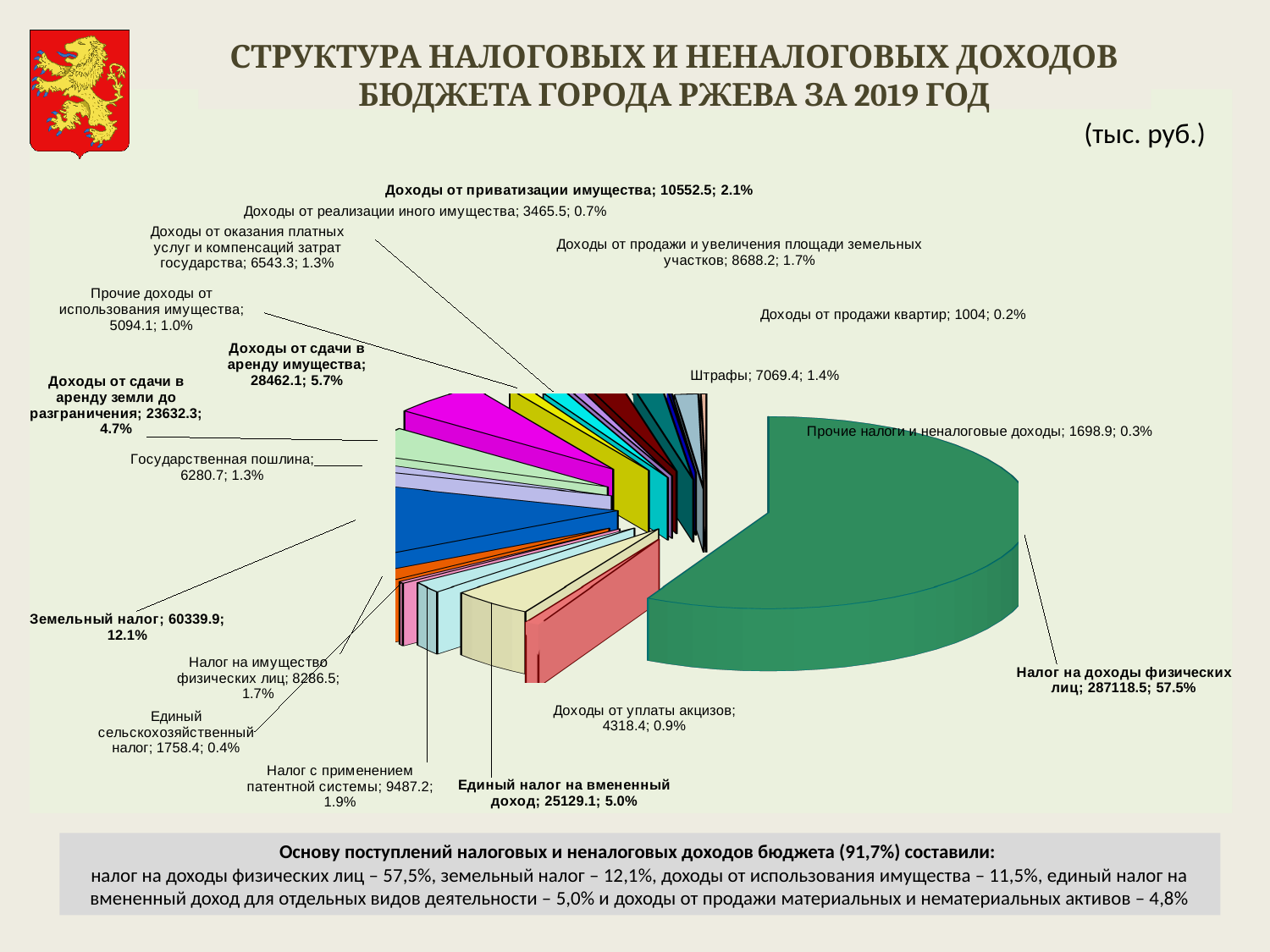
What share of the pie does Доходы от приватизации имущества represent? 2.1% What share of the pie does Земельный налог represent? 12.1% What is the value for Налог на доходы физических лиц? 287118.5 Which category has the largest slice of the pie? Налог на доходы физических лиц What kind of chart is shown on the slide? pie chart Which category has the smallest slice of the pie? Доходы от продажи квартир What is the difference between the values for Доходы от сдачи в аренду имущества and Доходы от сдачи в аренду земли до разграничения? 4829.8 What is the value for Единый налог на вмененный доход? 25129.1 Which is larger: Штрафы or Государственная пошлина? Штрафы What unit is stated for the values in the chart? тыс. руб. How many categories are shown in the pie chart? 18 What is the value for Налог с применением патентной системы? 9487.2